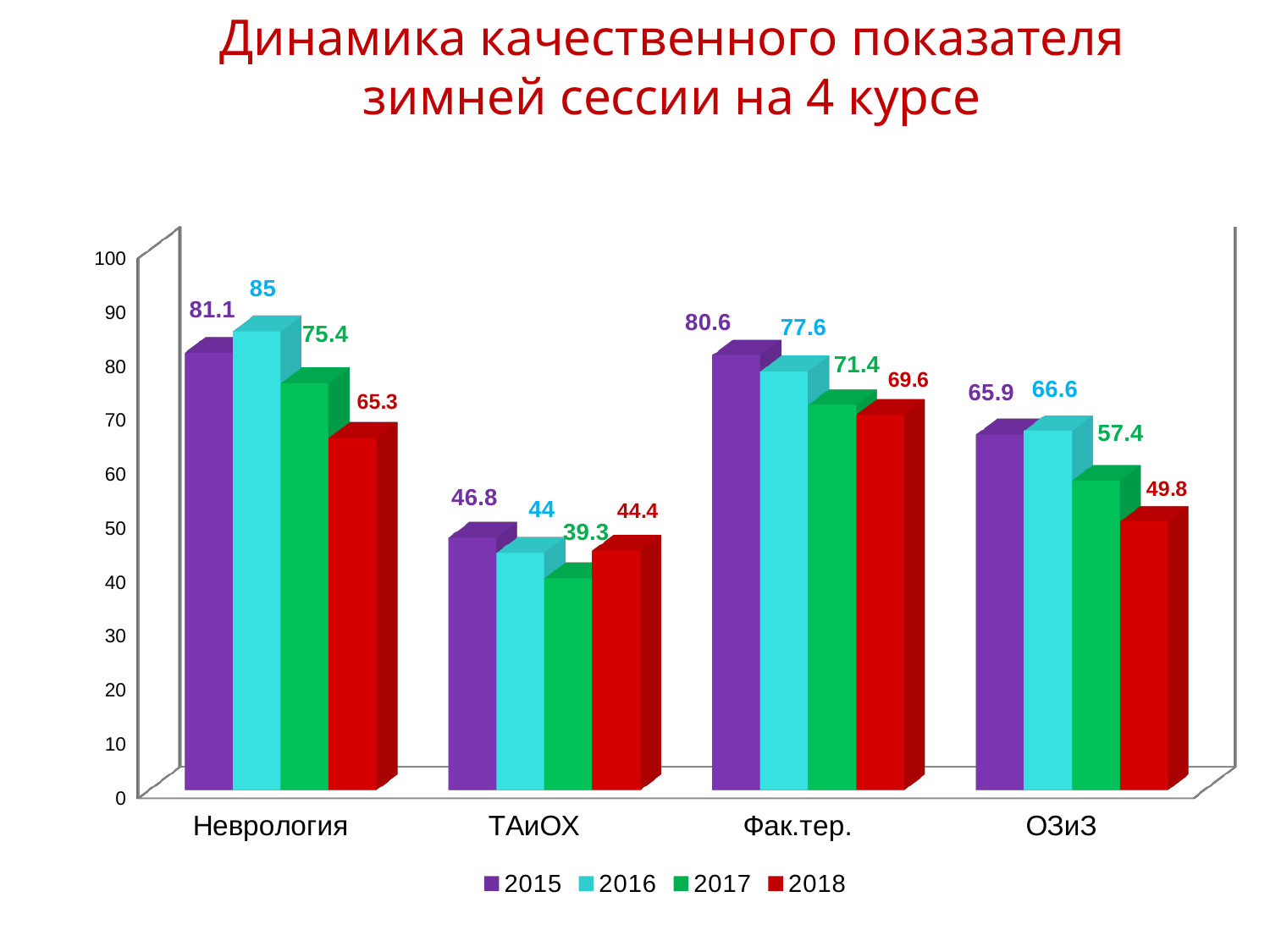
What is the value for Неврология in 2016? 85 Which category has the highest value in 2018? Фак.тер. What is the difference between the 2015 and 2018 values for Неврология? 15.8 What is the value for ТАиОХ in 2017? 39.3 How many categories are shown on the x axis? 4 Which is larger for ОЗиЗ: the 2016 value or the 2017 value? 2016 What is the value for Фак.тер. in 2015? 80.6 Which category has the lowest value in 2015? ТАиОХ What is the value for ОЗиЗ in 2018? 49.8 How many series does the legend list? 4 Do the values for Фак.тер. rise or fall from 2015 to 2018? Fall What kind of chart is shown on the slide? Bar chart